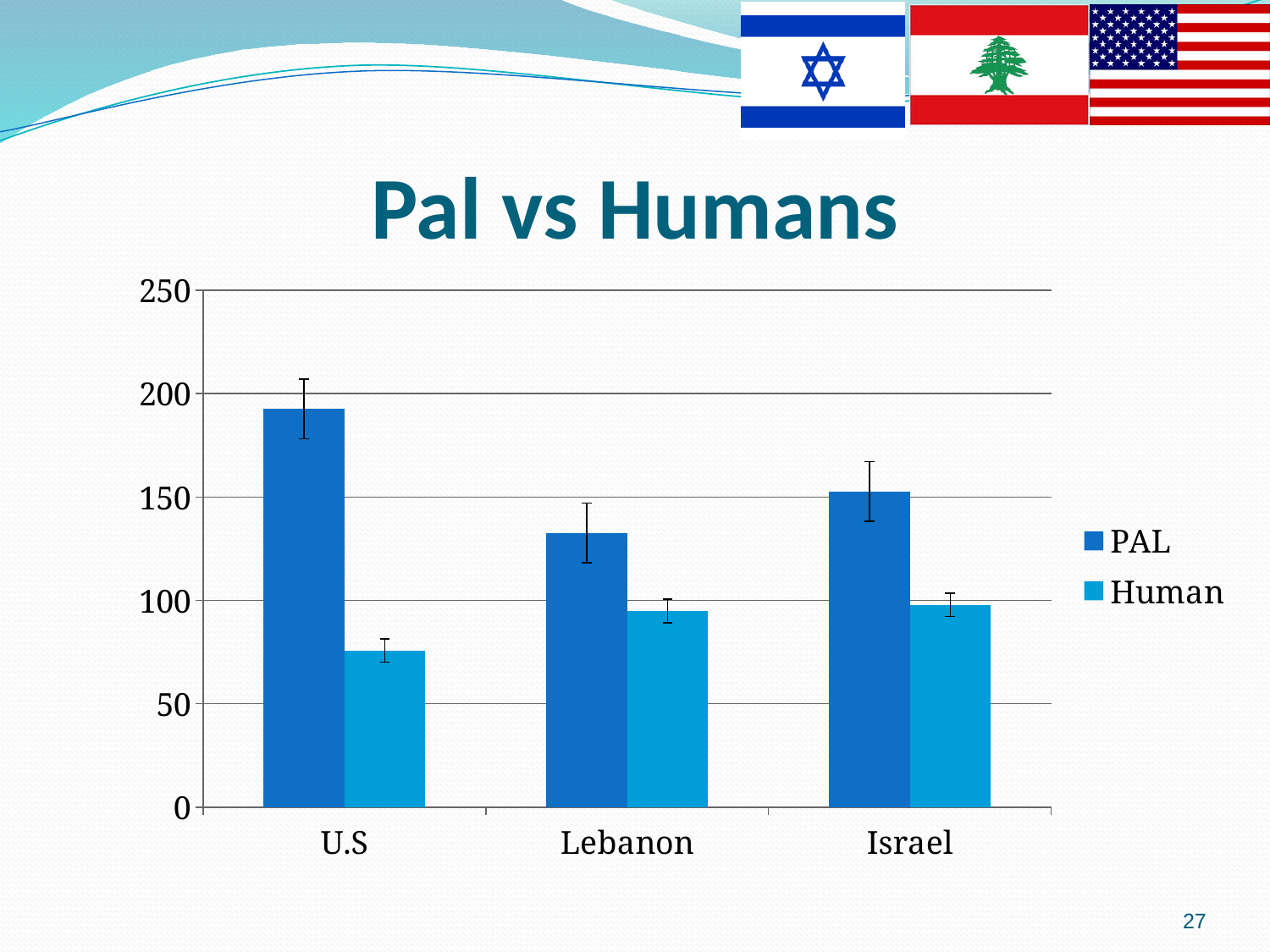
How many series does the legend list? 2 Is the Human value for U.S greater or less than 100? less Is the PAL value for Israel greater or less than 200? less Which category has the lowest Human value? U.S Which is larger for Israel, the PAL value or the Human value? PAL How many categories are shown on the x axis? 3 What kind of chart is shown on the slide? bar chart What is the title of the chart? Pal vs Humans Which category has the lowest PAL value? Lebanon Is the PAL value for Lebanon greater or less than 100? greater Which category has the highest PAL value? U.S